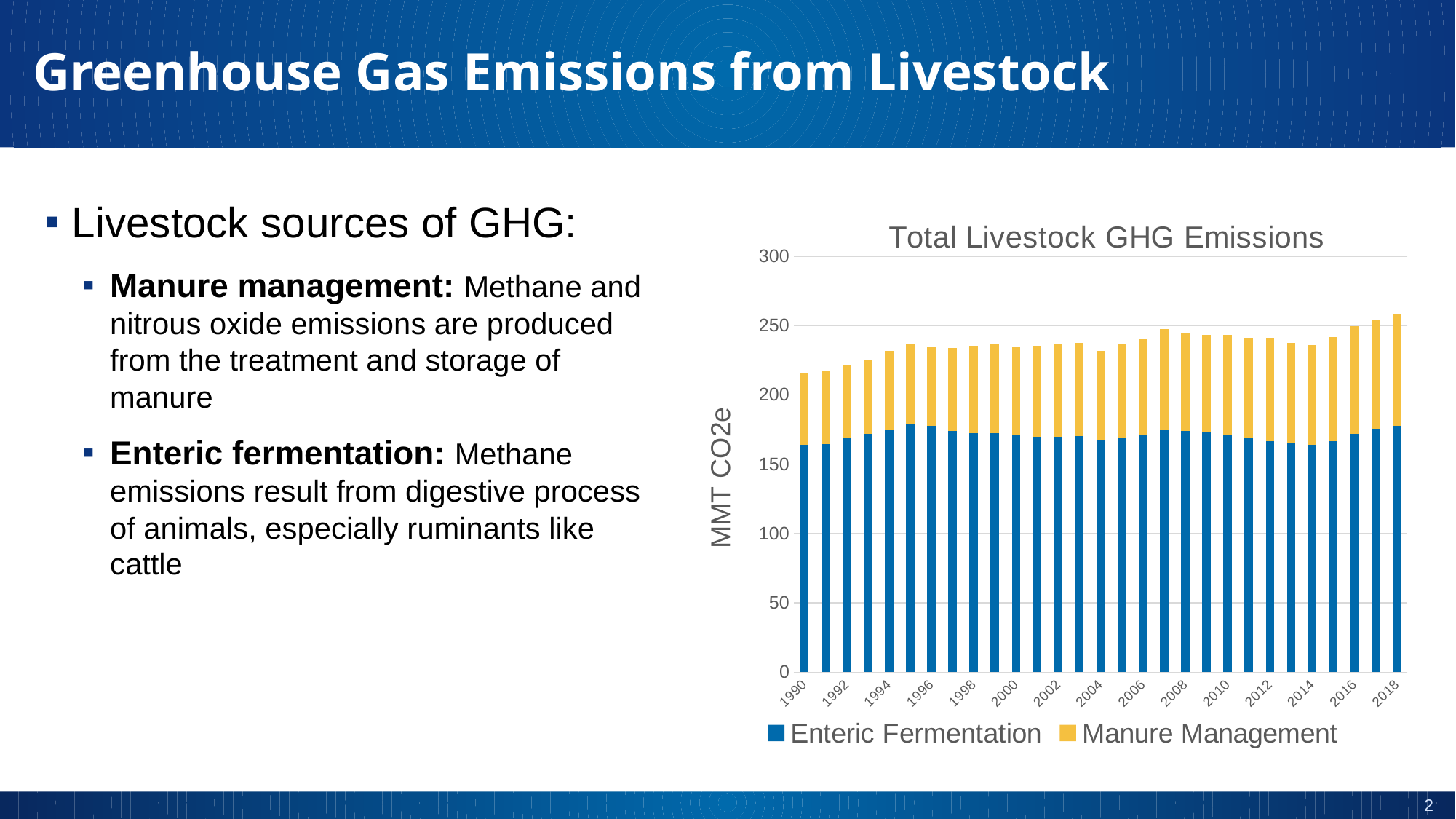
Which year has the highest total livestock GHG emissions in the chart? 2018 Is the total livestock GHG emissions value for 2018 greater or less than 250? greater Do total livestock GHG emissions generally rise or fall from 1990 to 2018? rise What is the label on the vertical axis of the chart? MMT CO2e What is the title of the chart? Total Livestock GHG Emissions Is the total livestock GHG emissions value for 1990 greater or less than 200? greater Which year has the lowest total livestock GHG emissions in the chart? 1990 Is the Enteric Fermentation value for 1990 greater or less than 200? less How many series does the legend of the chart list? 2 Which year has the larger total livestock GHG emissions, 1990 or 2018? 2018 What kind of chart is shown on the slide? Stacked bar chart